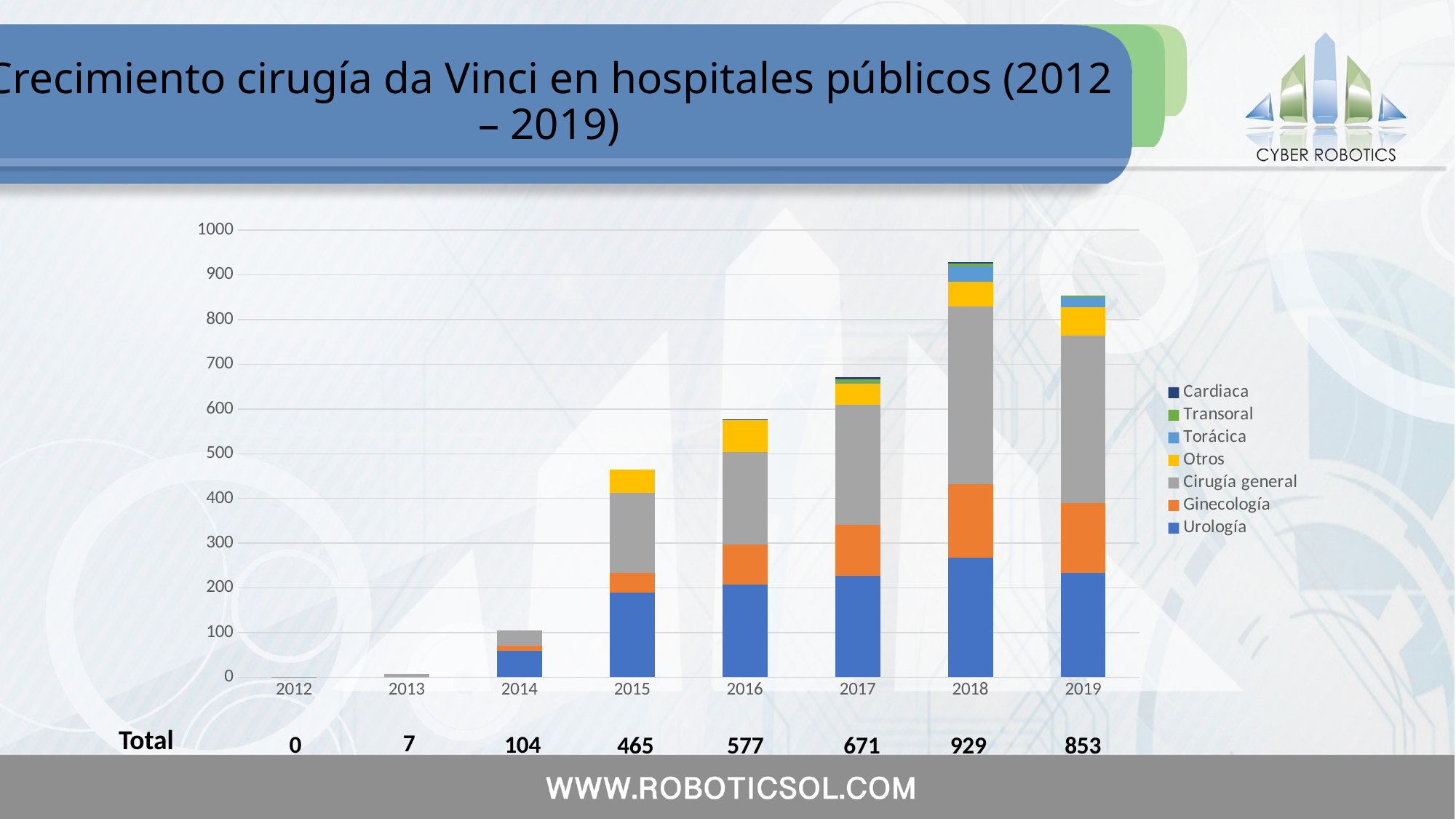
Which year has the lowest total? 2012 Do the totals rise or fall from 2012 to 2018? Rise What is the total number of surgeries shown for 2018? 929 Which year has the highest total? 2018 Which year has a larger total, 2018 or 2019? 2018 Is the Urología value for 2018 greater or less than 200? greater How many series does the legend list? 7 What is the total shown for 2015? 465 What is the difference between the totals for 2017 and 2016? 94 How many years are shown on the x axis? 8 What kind of chart is shown on the slide? Stacked bar chart What is the difference between the totals for 2018 and 2019? 76